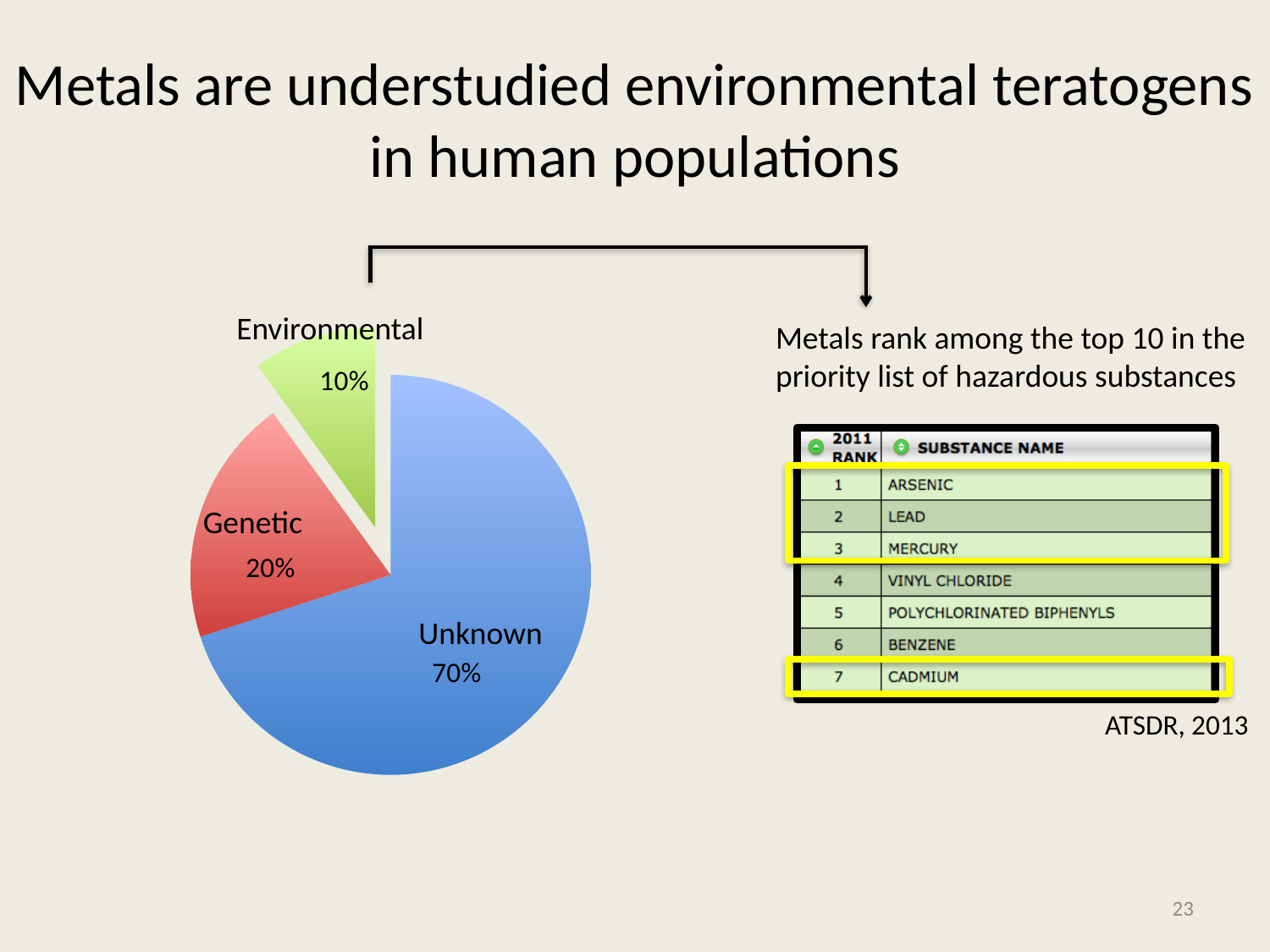
How many slices does the pie chart have? 3 Which slice of the pie chart is pulled out (exploded) from the rest? Environmental What is the difference in percentage points between the Genetic and Environmental slices? 10% Which slice of the pie chart is the largest? Unknown Which slice of the pie chart is the smallest? Environmental What share of the pie does the Environmental slice represent? 10% What share of the pie does the Unknown slice represent? 70% What colour is the Unknown slice of the pie chart? blue What is the difference in percentage points between the Unknown and Genetic slices? 50% Which is larger, the Genetic slice or the Environmental slice? Genetic What share of the pie does the Genetic slice represent? 20% What kind of chart is shown on the slide? pie chart